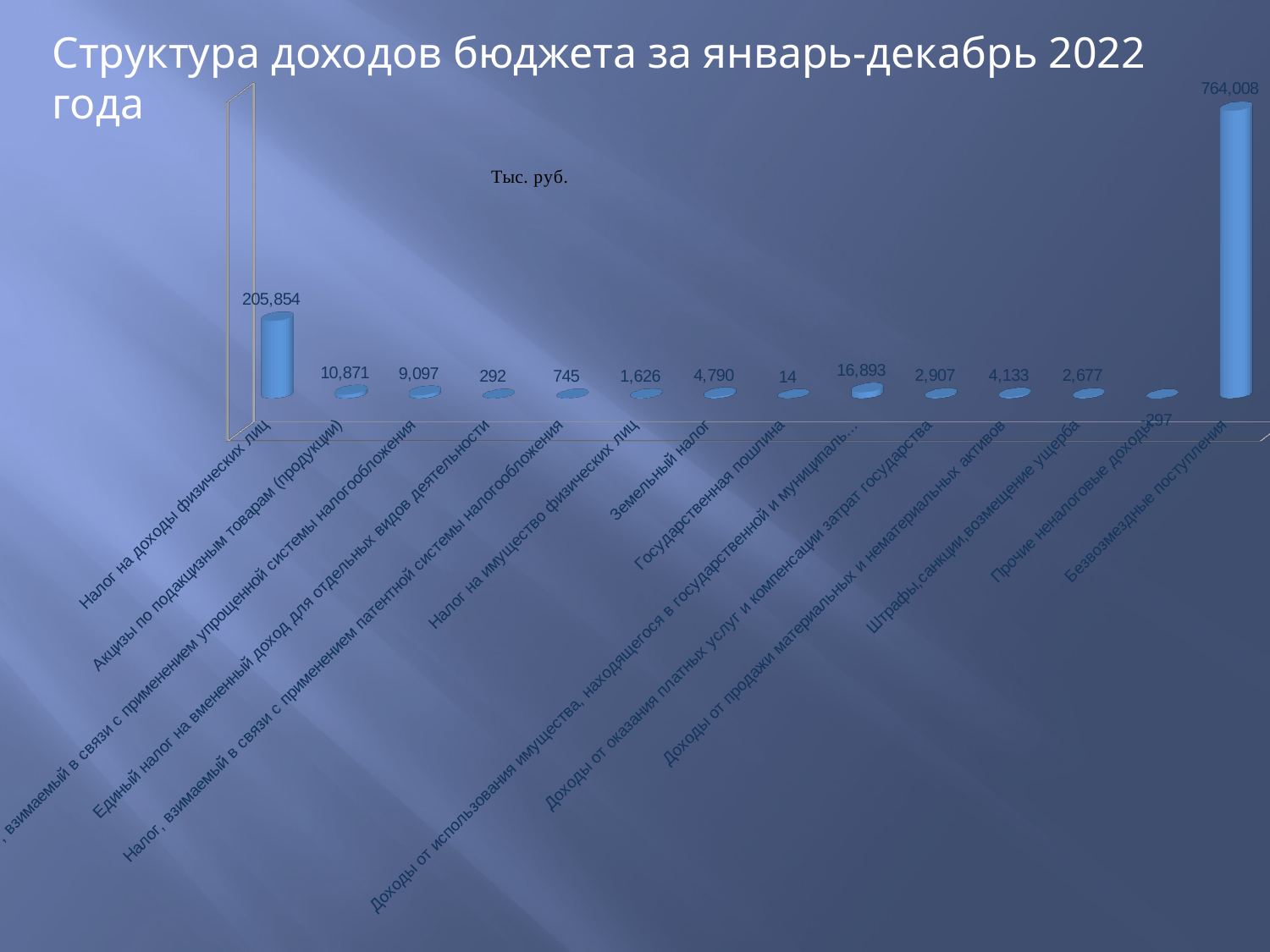
Which category has the highest value? Безвозмездные поступления What kind of chart is shown on the slide? Bar chart What is the difference between the values for Безвозмездные поступления and Налог на доходы физических лиц? 558,154 What is the value for Государственная пошлина? 14 What is the value for Безвозмездные поступления? 764,008 What is the title of the slide? Структура доходов бюджета за январь-декабрь 2022 года Which category has the lowest value? Прочие неналоговые доходы What unit is indicated on the chart? Тыс. руб. How many categories are shown in the chart? 14 What is the value for Земельный налог? 4,790 Which is larger: the value for Акцизы по подакцизным товарам (продукции) or the value for Налог на имущество физических лиц? Акцизы по подакцизным товарам (продукции) What is the value for Налог на доходы физических лиц? 205,854